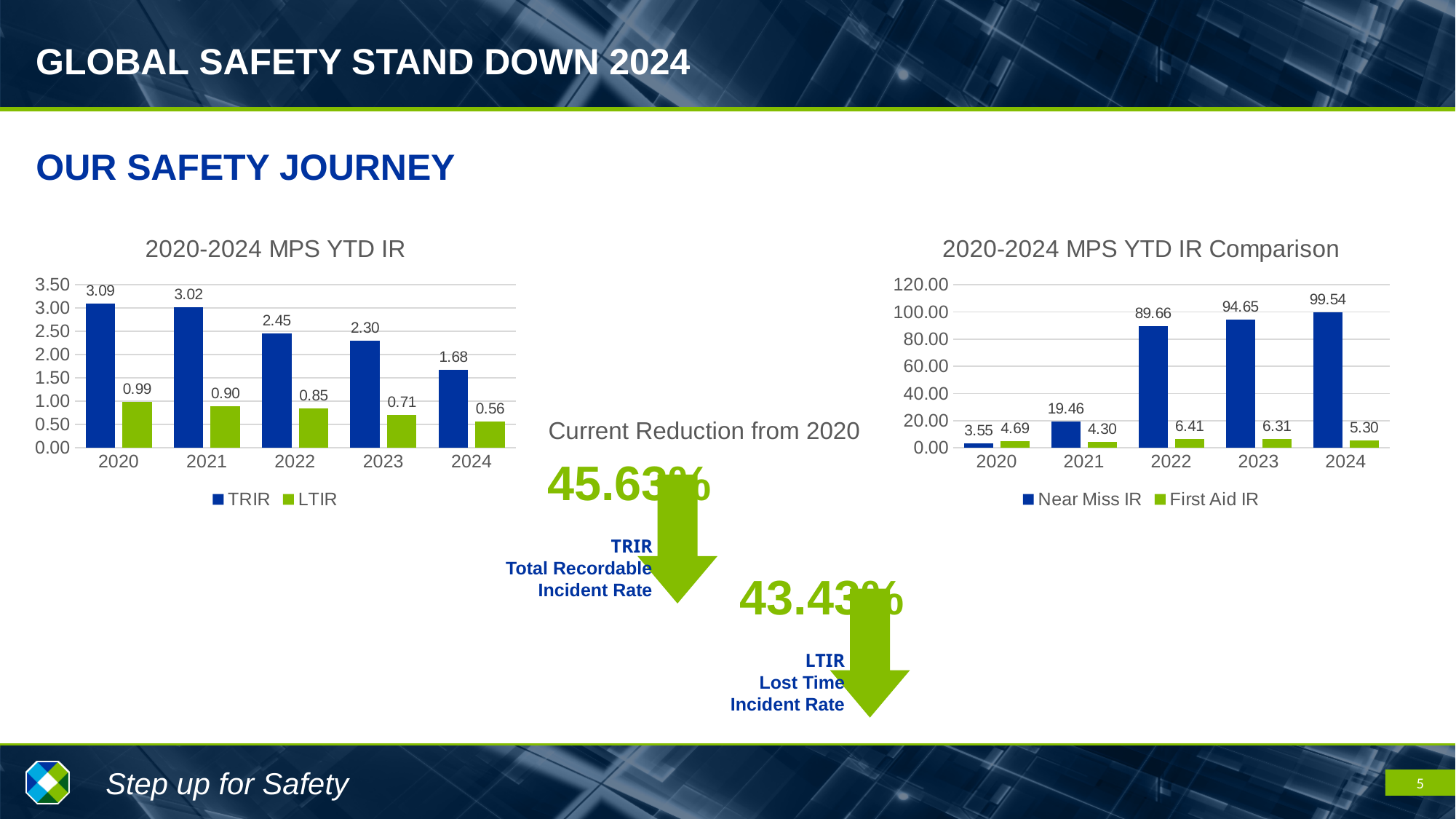
In the '2020-2024 MPS YTD IR' chart, does TRIR rise or fall from 2020 to 2024? fall In the '2020-2024 MPS YTD IR Comparison' chart, which year has the highest Near Miss IR? 2024 In the '2020-2024 MPS YTD IR' chart, what is the TRIR value for 2022? 2.45 In the '2020-2024 MPS YTD IR Comparison' chart, what is the First Aid IR value for 2021? 4.30 In the '2020-2024 MPS YTD IR' chart, what is the difference between the TRIR values for 2020 and 2024? 1.41 In the '2020-2024 MPS YTD IR Comparison' chart, which is larger in 2020: Near Miss IR or First Aid IR? First Aid IR In the '2020-2024 MPS YTD IR' chart, what is the LTIR value for 2024? 0.56 In the '2020-2024 MPS YTD IR Comparison' chart, what is the Near Miss IR value for 2023? 94.65 In the '2020-2024 MPS YTD IR' chart, which year has the highest TRIR? 2020 What type of chart is the '2020-2024 MPS YTD IR' chart? bar chart How many series does the legend of the '2020-2024 MPS YTD IR Comparison' chart list? 2 In the '2020-2024 MPS YTD IR' chart, which year has the lowest LTIR? 2024